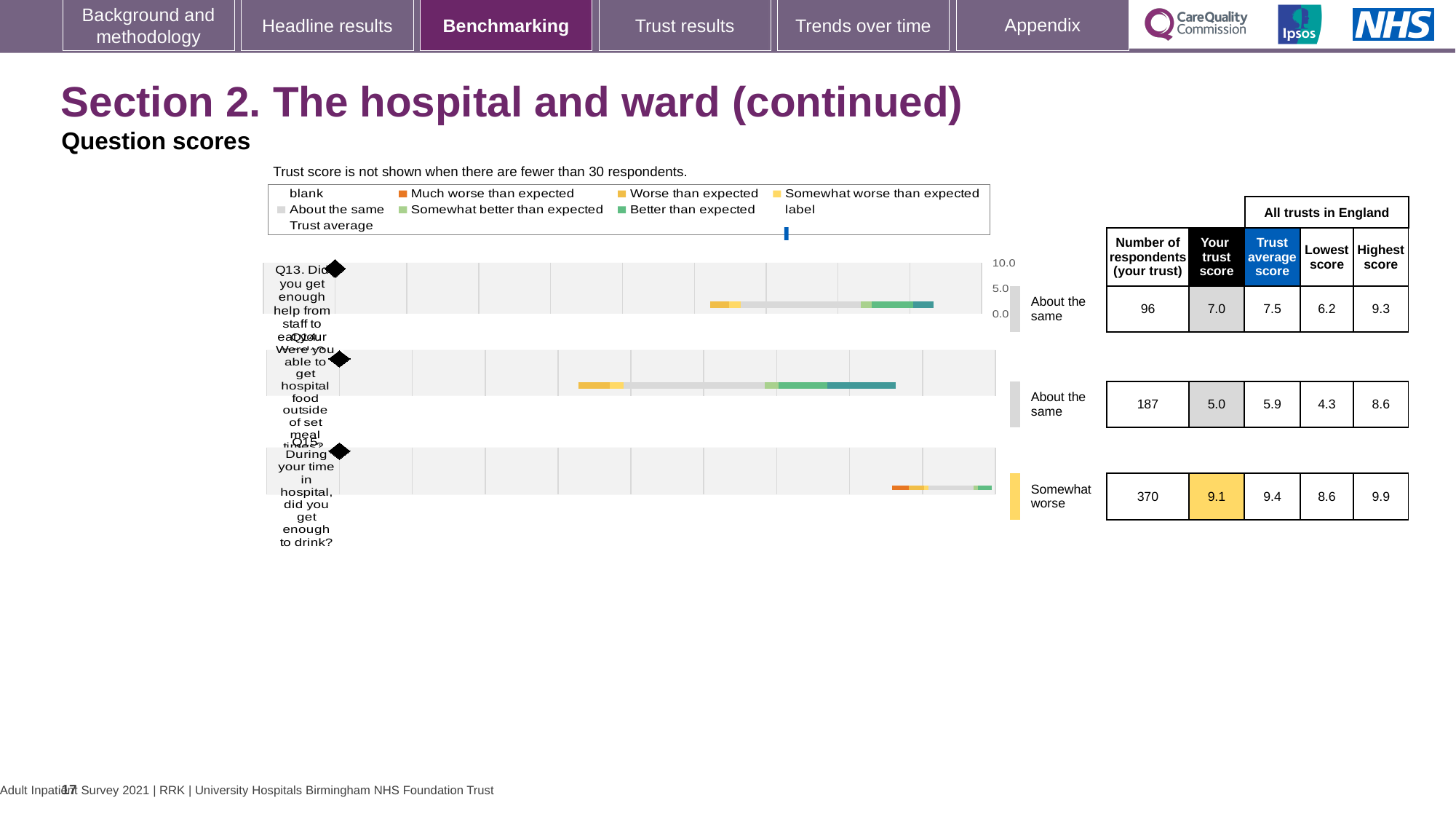
Which question has the lowest trust score? Q14 How many questions are plotted on the chart? 3 How many respondents answered Q15 (enough to drink)? 370 What is the lowest score across all trusts in England for Q13? 6.2 What benchmark category is shown for Q15? Somewhat worse Which question has the highest trust score? Q15 What is the difference between the trust average score and the trust score for Q14? 0.9 Which is larger, the trust score for Q13 or the trust score for Q15? Q15 What is the highest score across all trusts in England for Q14? 8.6 What is the trust score for Q13 (enough help from staff to eat meals)? 7.0 What kind of chart is used to show the question scores for Q13, Q14 and Q15? bar chart What is the difference between the highest and lowest scores for Q15? 1.3